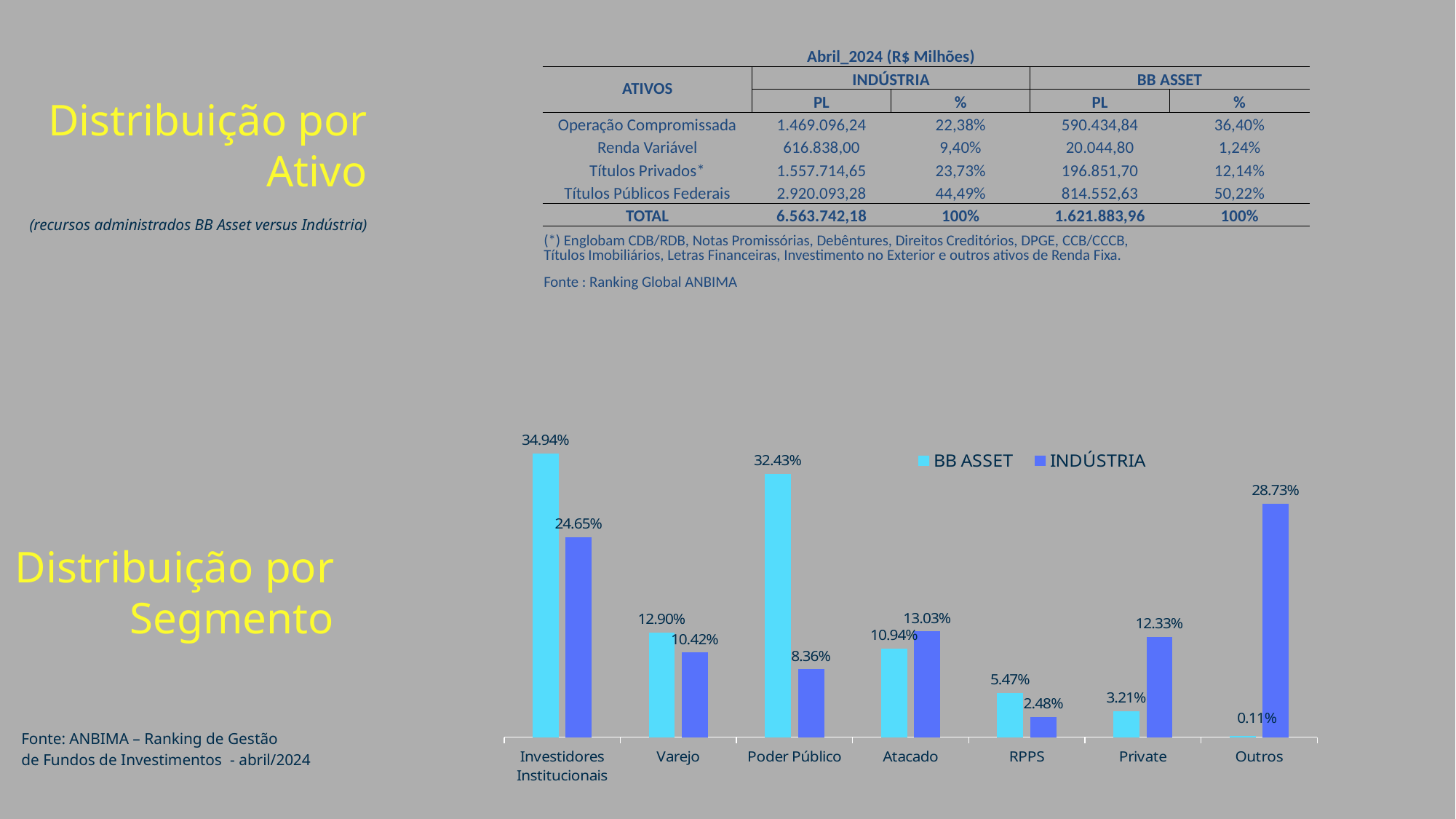
What is the difference between the BB ASSET and INDÚSTRIA values for Poder Público? 24.07 percentage points How many series does the chart legend list? 2 Which segment has the lowest BB ASSET value? Outros Which segment has the lowest INDÚSTRIA value? RPPS What type of chart is shown on the slide? Bar chart What is the INDÚSTRIA value for Outros? 28.73% How many segment categories are shown on the x axis of the chart? 7 Which segment has the highest BB ASSET value? Investidores Institucionais What is the BB ASSET value for Investidores Institucionais? 34.94% What is the INDÚSTRIA value for Poder Público? 8.36% For Private, which is larger: the BB ASSET value or the INDÚSTRIA value? INDÚSTRIA Which series is shown in light cyan in the chart? BB ASSET